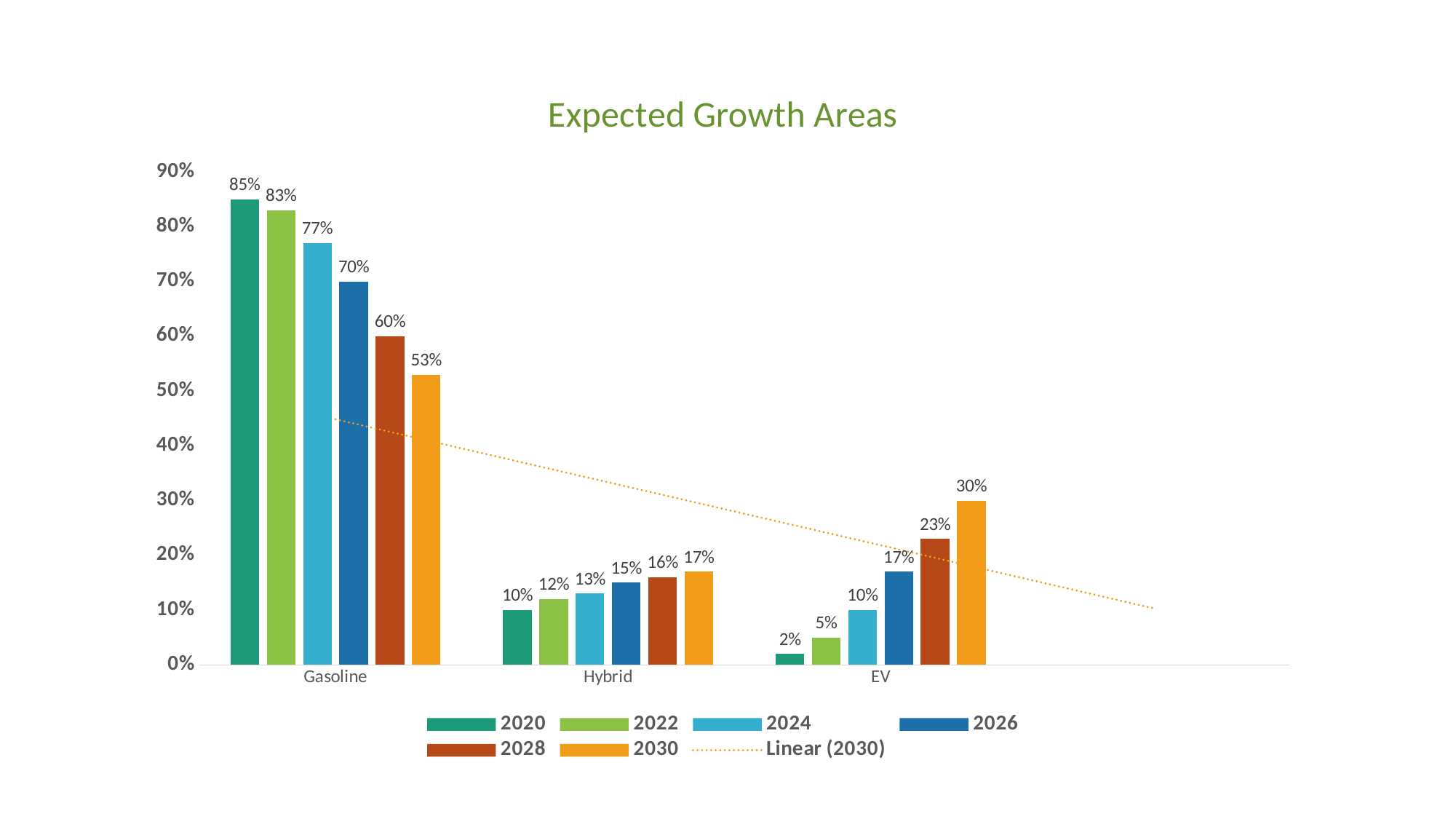
What is the value for Gasoline in 2020? 85% Which category has the lowest value in 2020? EV Do the Gasoline values rise or fall from 2020 to 2030? Fall What kind of chart is this? Bar chart What is the value for Hybrid in 2026? 15% What is the title of the chart? Expected Growth Areas What is the difference between the Gasoline values for 2020 and 2030? 32% Which category has the highest value in 2030? Gasoline Which is larger, the EV value in 2028 or the Hybrid value in 2028? EV value in 2028 How many entries does the legend list? 7 What is the value for EV in 2030? 30% How many categories are shown on the x axis? 3